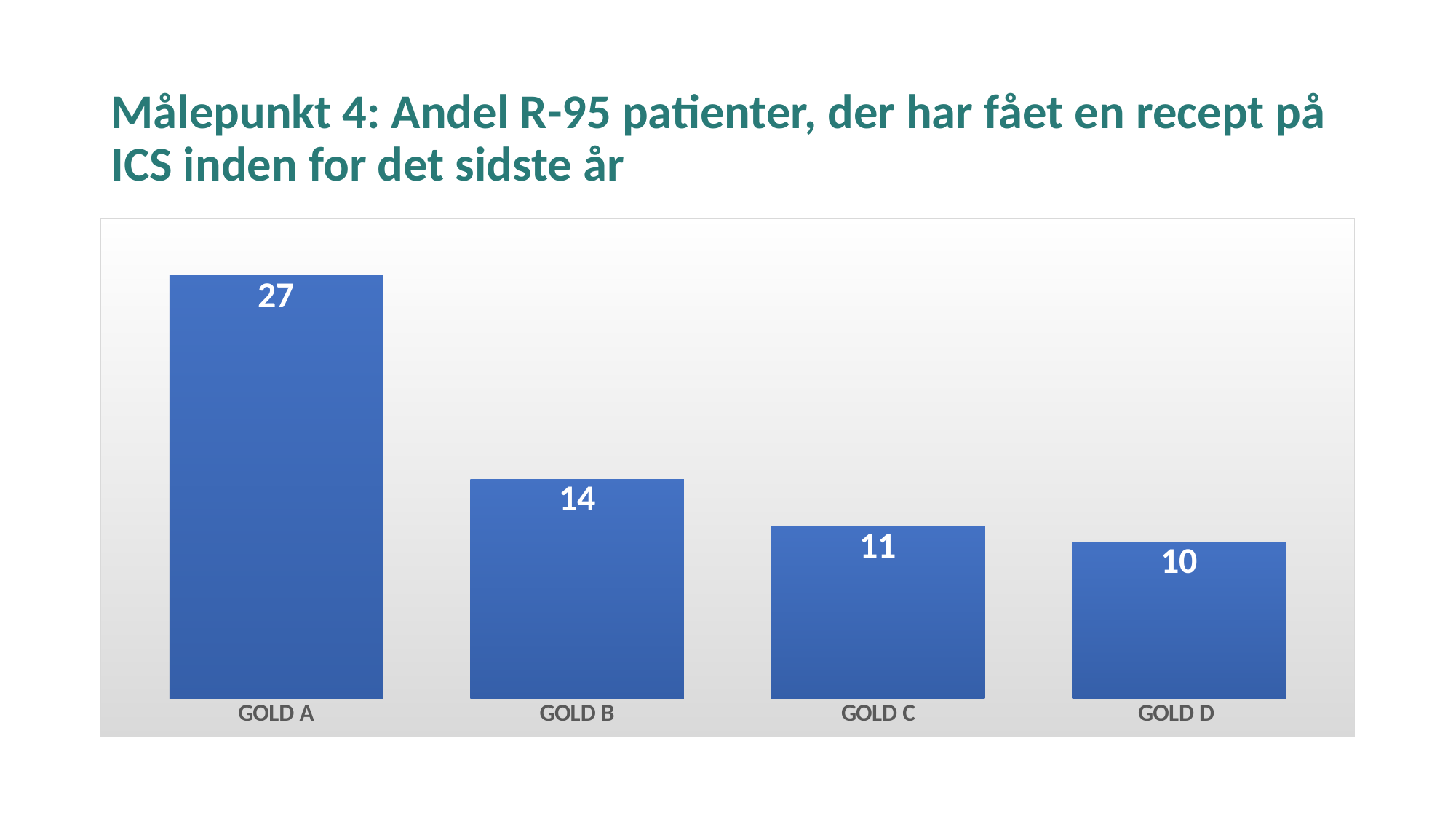
How many categories are shown in the chart? 4 What is the difference between the values for GOLD C and GOLD D? 1 What is the difference between the values for GOLD A and GOLD B? 13 What is the value for GOLD D? 10 What is the value for GOLD C? 11 Which category has the lowest value? GOLD D What is the value for GOLD B? 14 Do the values rise or fall from GOLD A to GOLD D? Fall Which is larger, the value for GOLD B or the value for GOLD C? GOLD B What kind of chart is shown on the slide? Bar chart What is the value for GOLD A? 27 Which category has the highest value? GOLD A